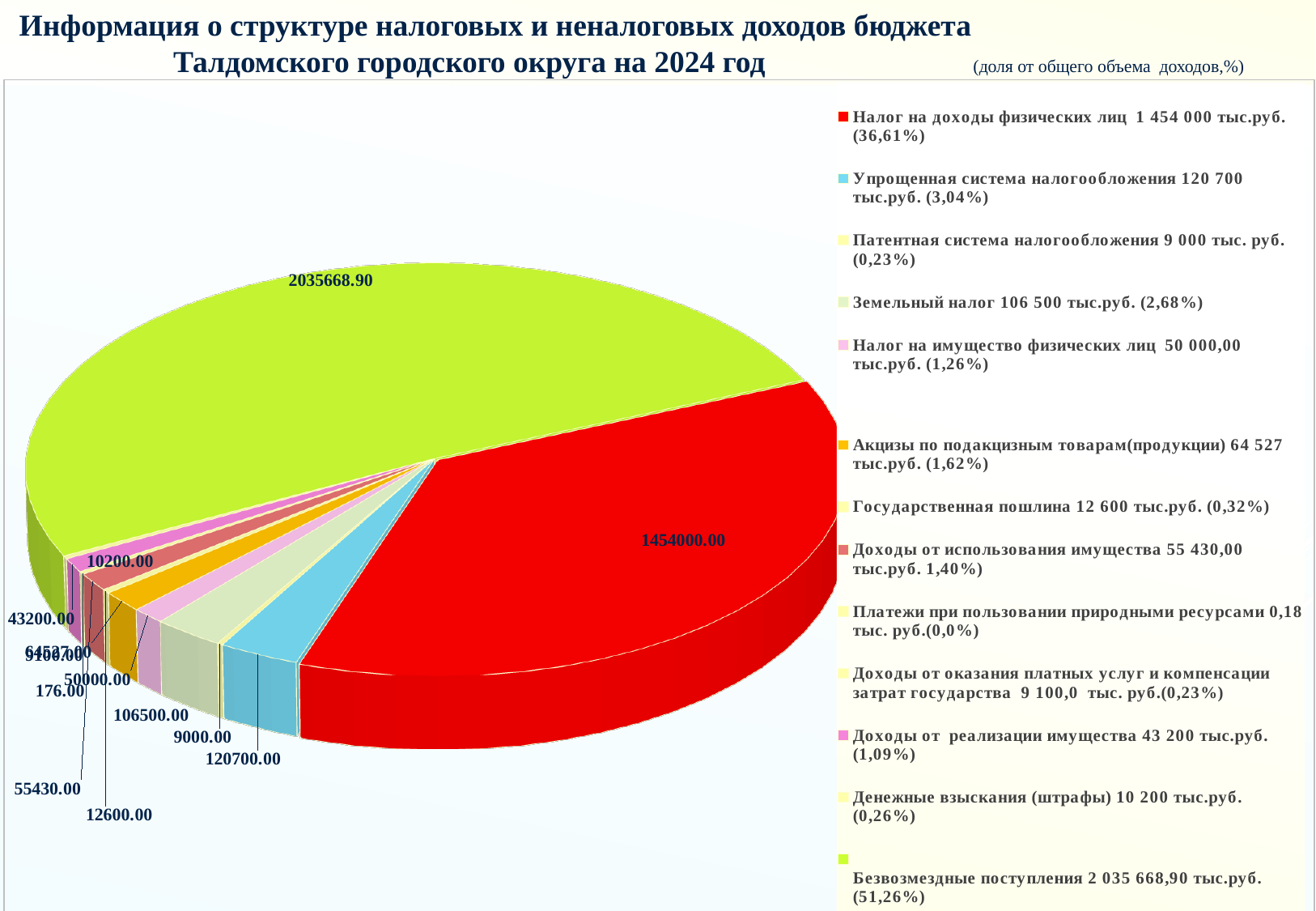
Which is larger: the slice for Упрощенная система налогообложения or the slice for Земельный налог? Упрощенная система налогообложения What value is labelled on the slice for Налог на доходы физических лиц? 1454000.00 What is the difference between the labelled values for Безвозмездные поступления and Налог на доходы физических лиц? 581668.90 What share of the pie does Безвозмездные поступления represent, according to the legend? 51,26% What kind of chart is shown on the slide? pie chart What value is labelled on the slice for Безвозмездные поступления? 2035668.90 What colour is the slice for Налог на доходы физических лиц? red What share of the pie does Налог на доходы физических лиц represent, according to the legend? 36,61% Which category has the smallest slice of the pie? Платежи при пользовании природными ресурсами Which category has the largest slice of the pie? Безвозмездные поступления What value is labelled on the slice for Денежные взыскания (штрафы)? 10200.00 How many categories does the pie chart have? 13